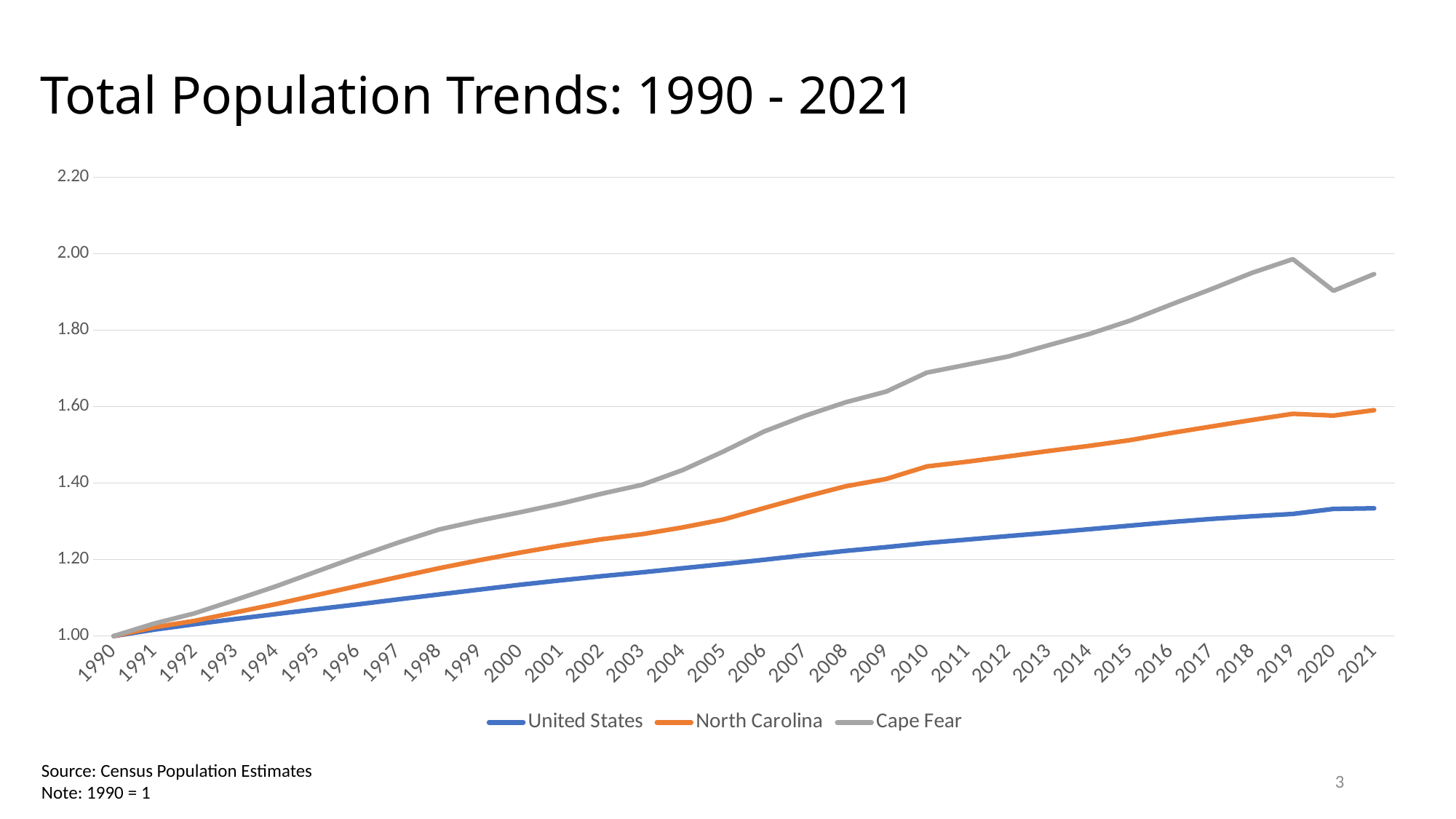
Which series has the highest value in 2021? Cape Fear Which is larger in 2015, the value for North Carolina or the value for United States? North Carolina Which series has the lowest value in 2021? United States How many series does the legend list? 3 Is the value for North Carolina in 2010 greater or less than 1.40? greater Is the value for United States in 2021 greater or less than 1.40? less What is the title of the chart? Total Population Trends: 1990 - 2021 How many years are plotted along the x axis? 32 Is the value for Cape Fear in 2019 greater or less than 1.80? greater What is the value for Cape Fear in 1990? 1.00 Does the United States line generally rise or fall from 1990 to 2021? Rise What kind of chart is shown on the slide? Line chart